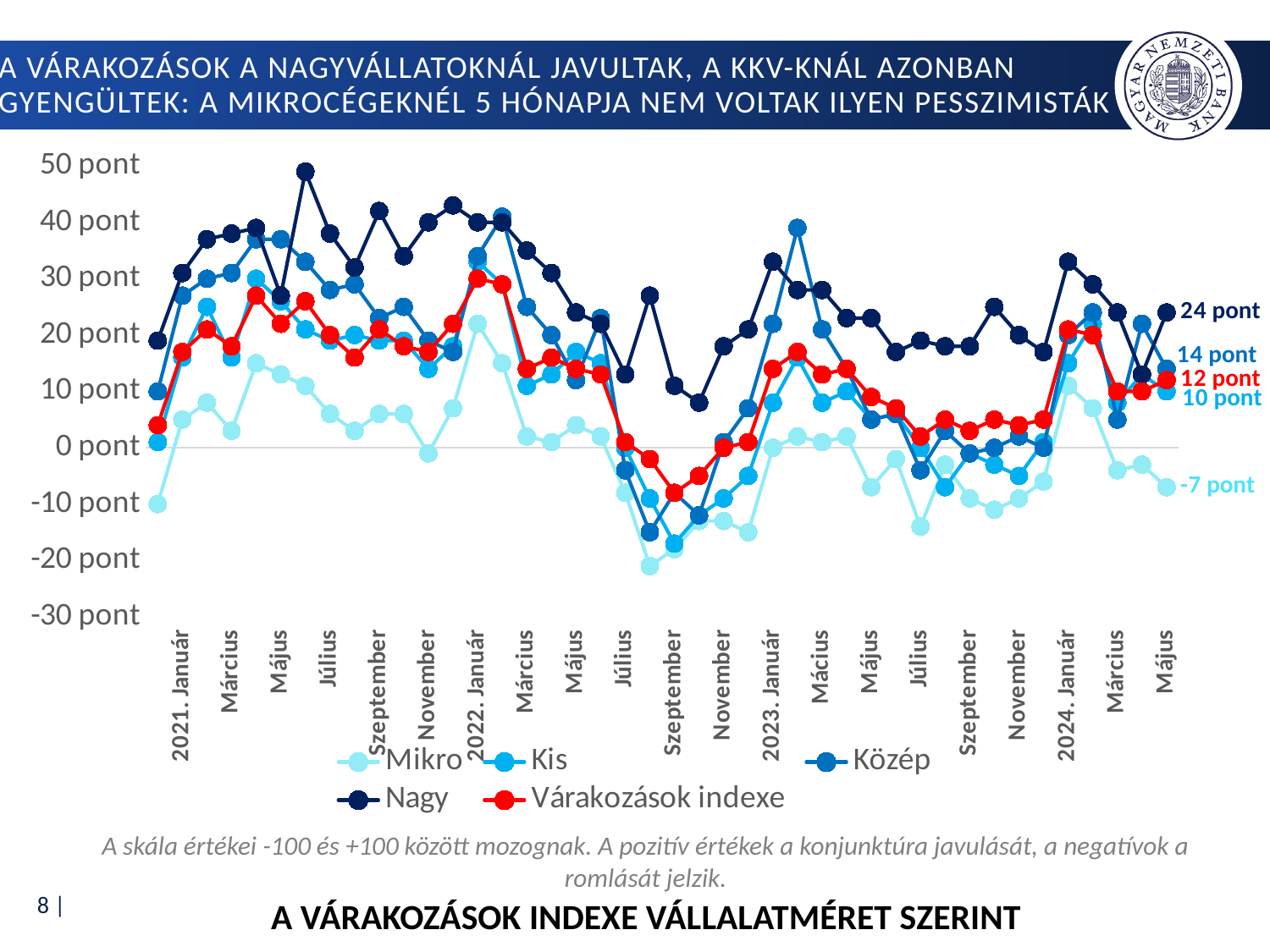
Which series has the lowest value at the last point (2024 Május)? Mikro Is the value for Mikro in 2021. Január greater or less than 0 pont? greater What is the title of the chart shown at the bottom of the slide? A VÁRAKOZÁSOK INDEXE VÁLLALATMÉRET SZERINT How many series does the legend list? 5 What kind of chart is shown on the slide? line chart Which series has the highest value at the last point (2024 Május)? Nagy What is the value of the Várakozások indexe series at the last point (2024 Május)? 12 pont What is the value of the Mikro series at the last point (2024 Május)? -7 pont What is the difference between the Nagy and Közép values at the last point (2024 Május)? 10 pont At the last point (2024 Május), which is larger: the Közép value or the Kis value? Közép What is the value of the Nagy series at the last point (2024 Május)? 24 pont What is the value of the Kis series at the last point (2024 Május)? 10 pont